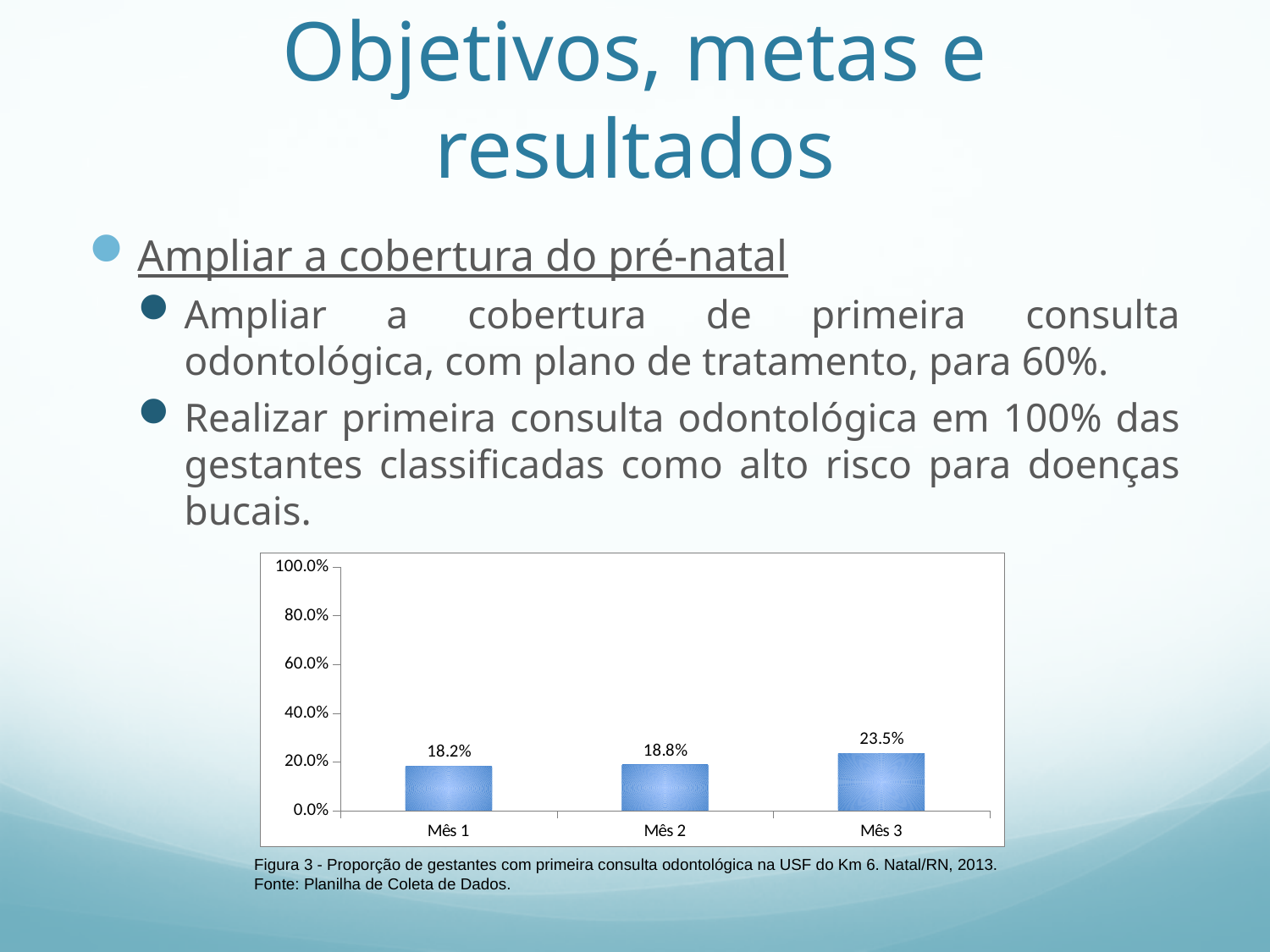
Which month has the lowest value? Mês 1 Which is larger, the value for Mês 3 or the value for Mês 2? Mês 3 What is the difference between the values for Mês 2 and Mês 1? 0.6% Which month has the highest value? Mês 3 What is the difference between the values for Mês 3 and Mês 1? 5.3% What is the value for Mês 1? 18.2% Is the value for Mês 3 greater or less than 20.0%? greater Do the values rise or fall from Mês 1 to Mês 3? rise What is the value for Mês 2? 18.8% What kind of chart is shown on the slide? bar chart How many months are shown on the x axis? 3 What is the value for Mês 3? 23.5%